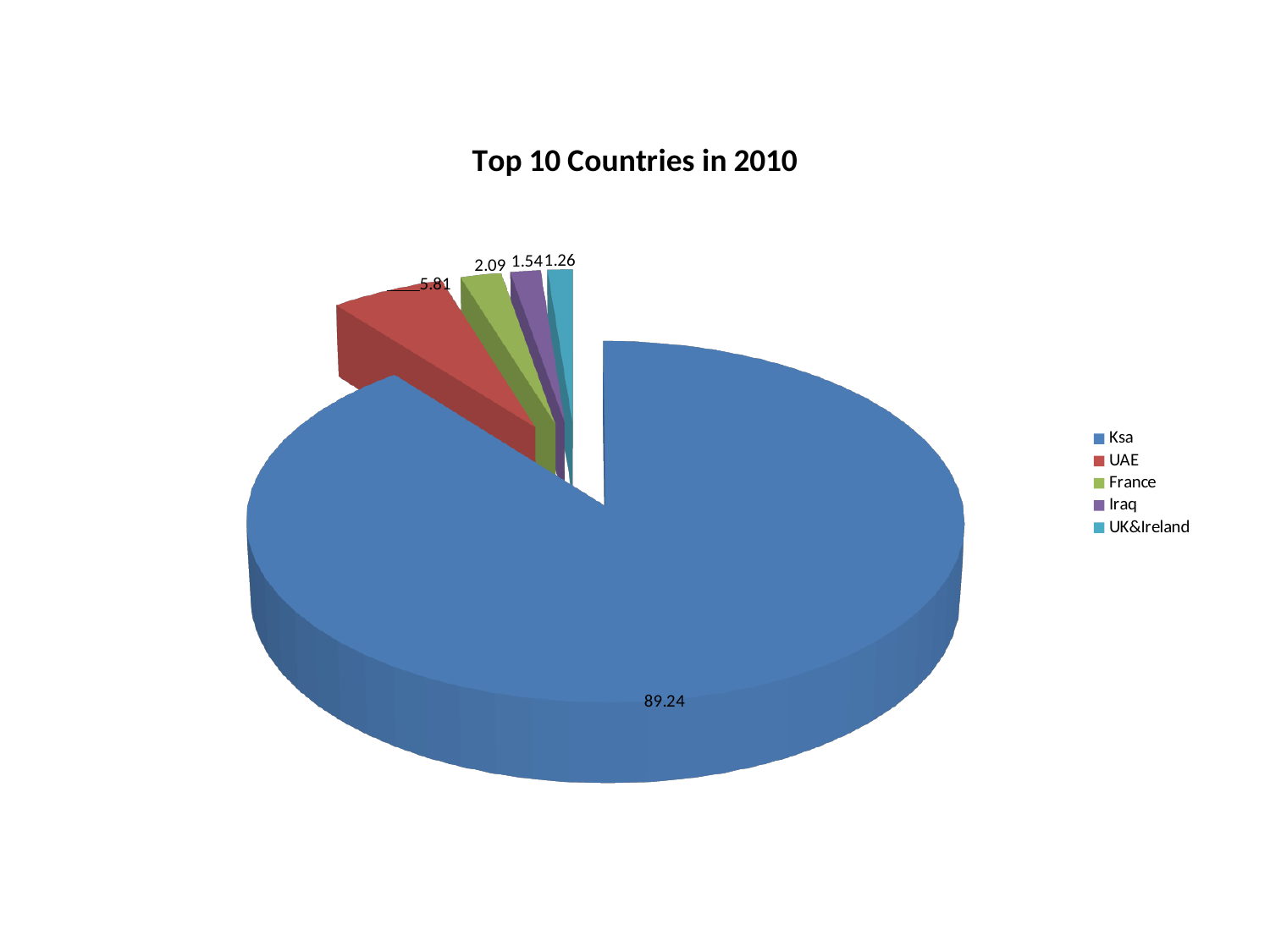
Which country has the smallest slice of the pie? UK&Ireland How many countries are listed in the legend? 5 What is the value shown for France? 2.09 What is the value shown for Iraq? 1.54 Which is larger, the value for Iraq or the value for UK&Ireland? Iraq What type of chart is shown on the slide? pie chart What is the value shown for UK&Ireland? 1.26 What is the title of the chart? Top 10 Countries in 2010 Which country has the largest slice of the pie? Ksa What is the value shown for UAE? 5.81 What is the value shown for Ksa? 89.24 What is the difference between the values for UAE and France? 3.72